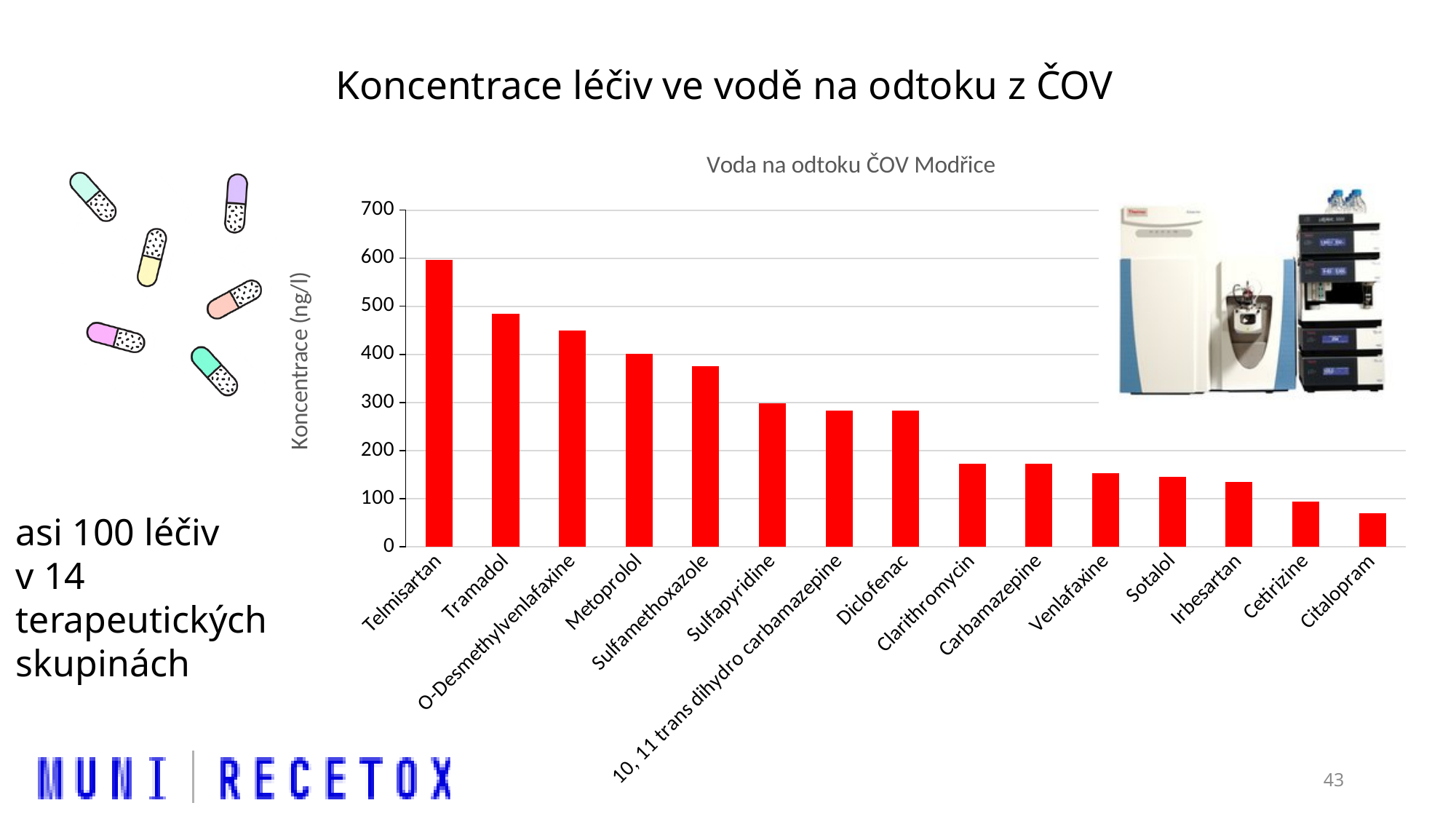
What kind of chart is shown on the slide? bar chart Which has a higher concentration, Tramadol or Metoprolol? Tramadol Which substance has the highest concentration in the chart? Telmisartan Is the value for Citalopram greater or less than 100? less Is the value for Diclofenac greater or less than 300? less Which substance has the lowest concentration in the chart? Citalopram What is the label of the vertical axis of the chart? Koncentrace (ng/l) Do the concentrations rise or fall from left to right along the x axis? fall Is the value for Sulfamethoxazole greater or less than 400? less Which has a higher concentration, Sulfamethoxazole or Sotalol? Sulfamethoxazole How many substances (bars) are shown in the chart? 15